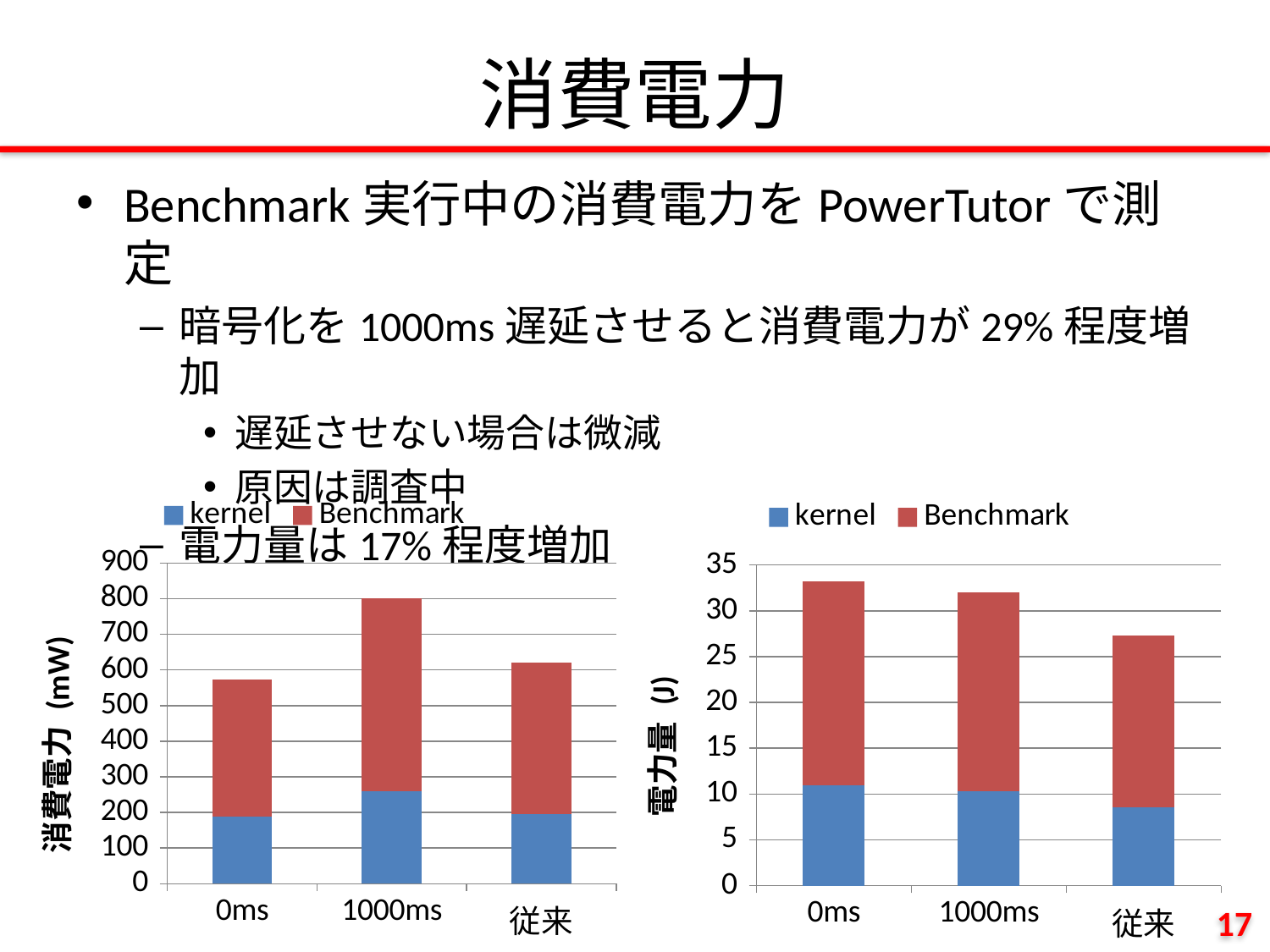
In the left chart (消費電力 (mW)), is the kernel value for 1000ms greater or less than 200? greater In the left chart (消費電力 (mW)), is the total for 1000ms greater or less than 700? greater How many series does the legend of the right chart (電力量 (J)) list? 2 In the right chart (電力量 (J)), is the total for 0ms greater or less than 30? greater In the right chart (電力量 (J)), which category has the lowest total bar? 従来 In the left chart (消費電力 (mW)), which category has the lowest total bar? 0ms What kind of chart is the left chart (消費電力 (mW))? stacked bar chart In the left chart (消費電力 (mW)), which category has the highest total bar? 1000ms In the right chart (電力量 (J)), which is larger, the total for 1000ms or the total for 従来? 1000ms How many categories are shown on the x axis of the left chart (消費電力 (mW))? 3